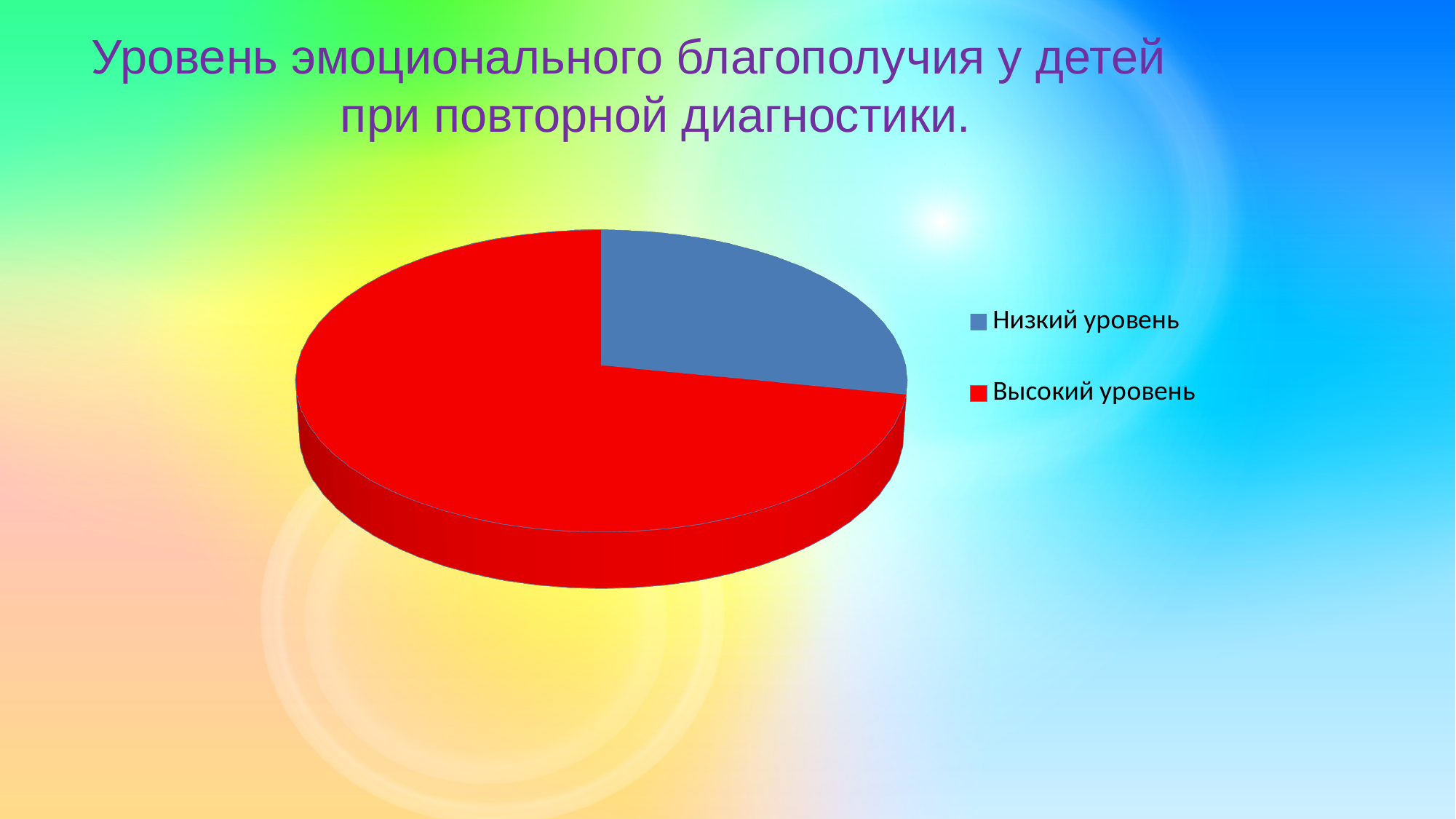
What colour is the slice for Высокий уровень in the pie chart? Red Which slice is larger: Низкий уровень or Высокий уровень? Высокий уровень What kind of chart is shown on the slide? Pie chart How many entries does the legend of the pie chart list? 2 Which category takes the smallest share of the pie chart? Низкий уровень How many slices does the pie chart have? 2 What colour is the slice for Низкий уровень in the pie chart? Blue Which category takes the largest share of the pie chart? Высокий уровень